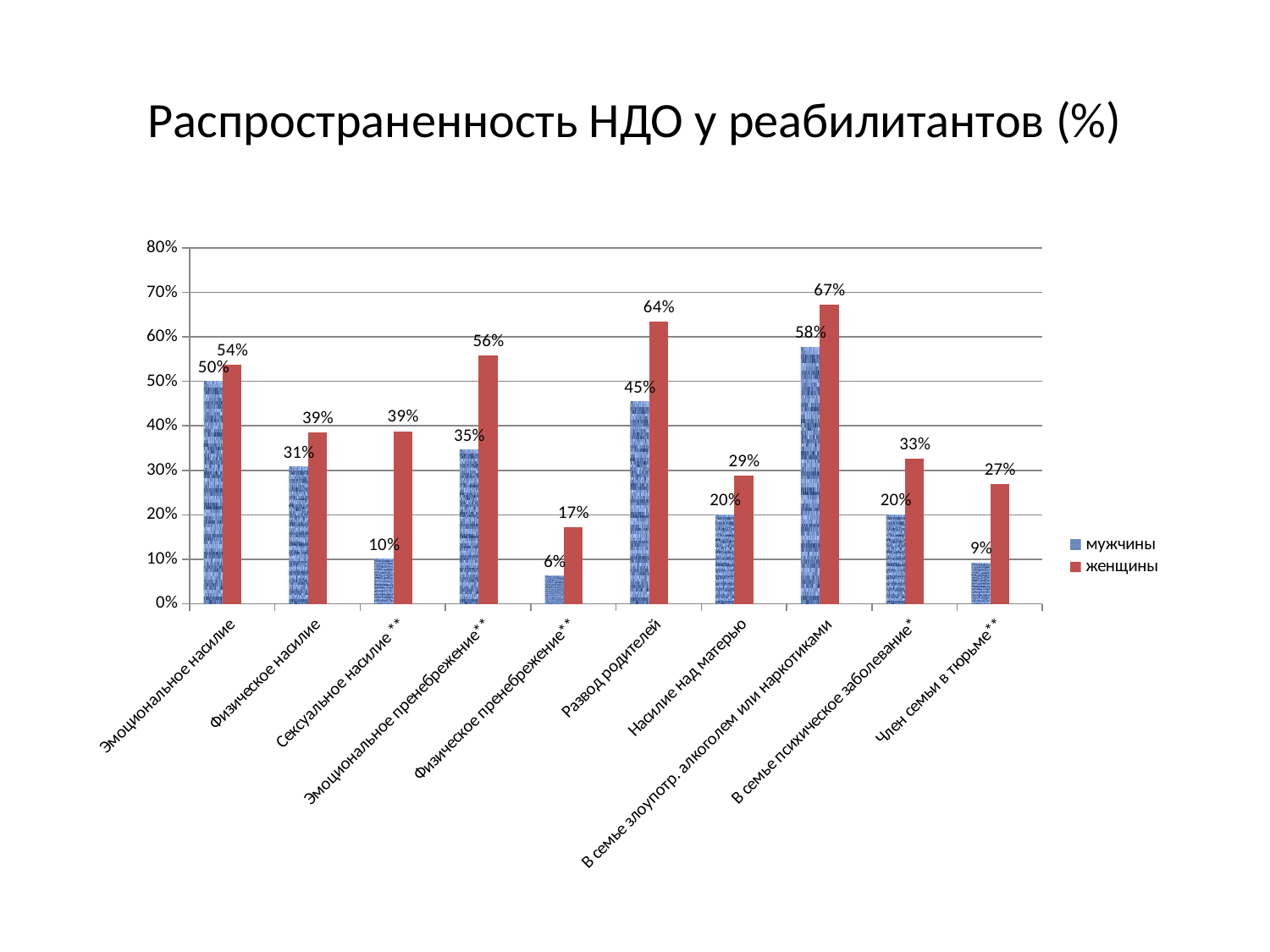
How many series does the legend list? 2 What is the value for мужчины in the category Сексуальное насилие**? 10% What is the value for мужчины in the category Развод родителей? 45% What kind of chart is shown on the slide? Bar chart Which category has the highest value for женщины? В семье злоупотр. алкоголем или наркотиками Which is larger: the женщины value for Физическое насилие or the женщины value for Член семьи в тюрьме**? Физическое насилие What is the difference between the женщины and мужчины values in the category Сексуальное насилие**? 29% What is the title of the chart? Распространенность НДО у реабилитантов (%) Which category has the lowest value for мужчины? Физическое пренебрежение** What is the value for женщины in the category Эмоциональное пренебрежение**? 56% How many categories are shown on the x axis? 10 Which series is shown in red? женщины